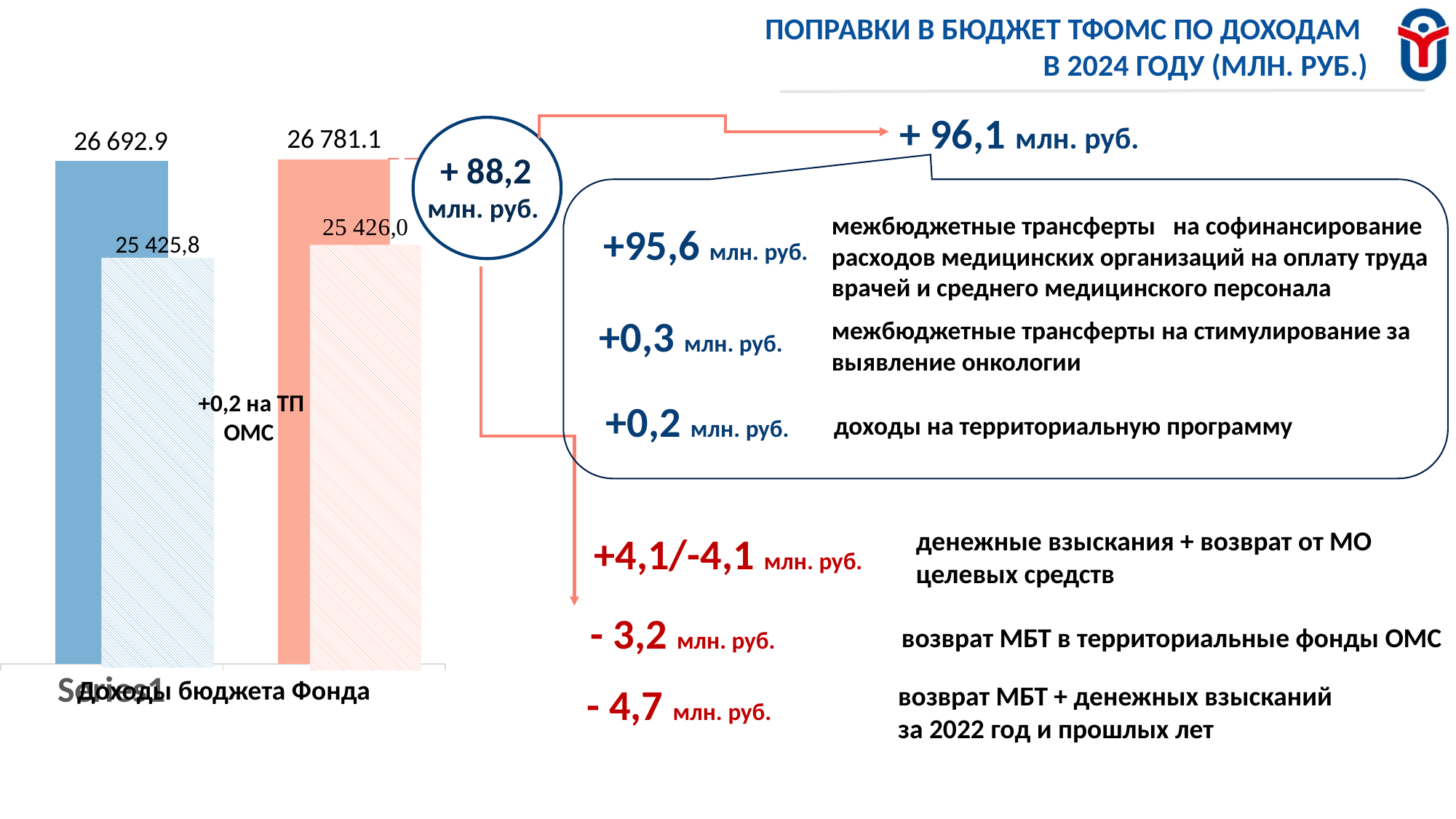
What value is labelled on the solid red bar? 26 781.1 How many bars are plotted in the chart? 4 What is the category label shown under the bars? Доходы бюджета Фонда What value is labelled on the hatched blue bar? 25 425,8 What kind of chart is shown on the slide? bar chart What is the difference between the solid red bar (26 781.1) and the solid blue bar (26 692.9)? 88,2 What value is labelled on the solid blue bar? 26 692.9 What value is labelled on the hatched red bar? 25 426,0 Which is larger according to the data labels: the solid red bar or the solid blue bar? the solid red bar What is the title of the slide containing the chart? ПОПРАВКИ В БЮДЖЕТ ТФОМС ПО ДОХОДАМ В 2024 ГОДУ (МЛН. РУБ.) Which bar has the highest labelled value? the solid red bar (26 781.1) What is the difference between the hatched red bar (25 426,0) and the hatched blue bar (25 425,8)? 0,2